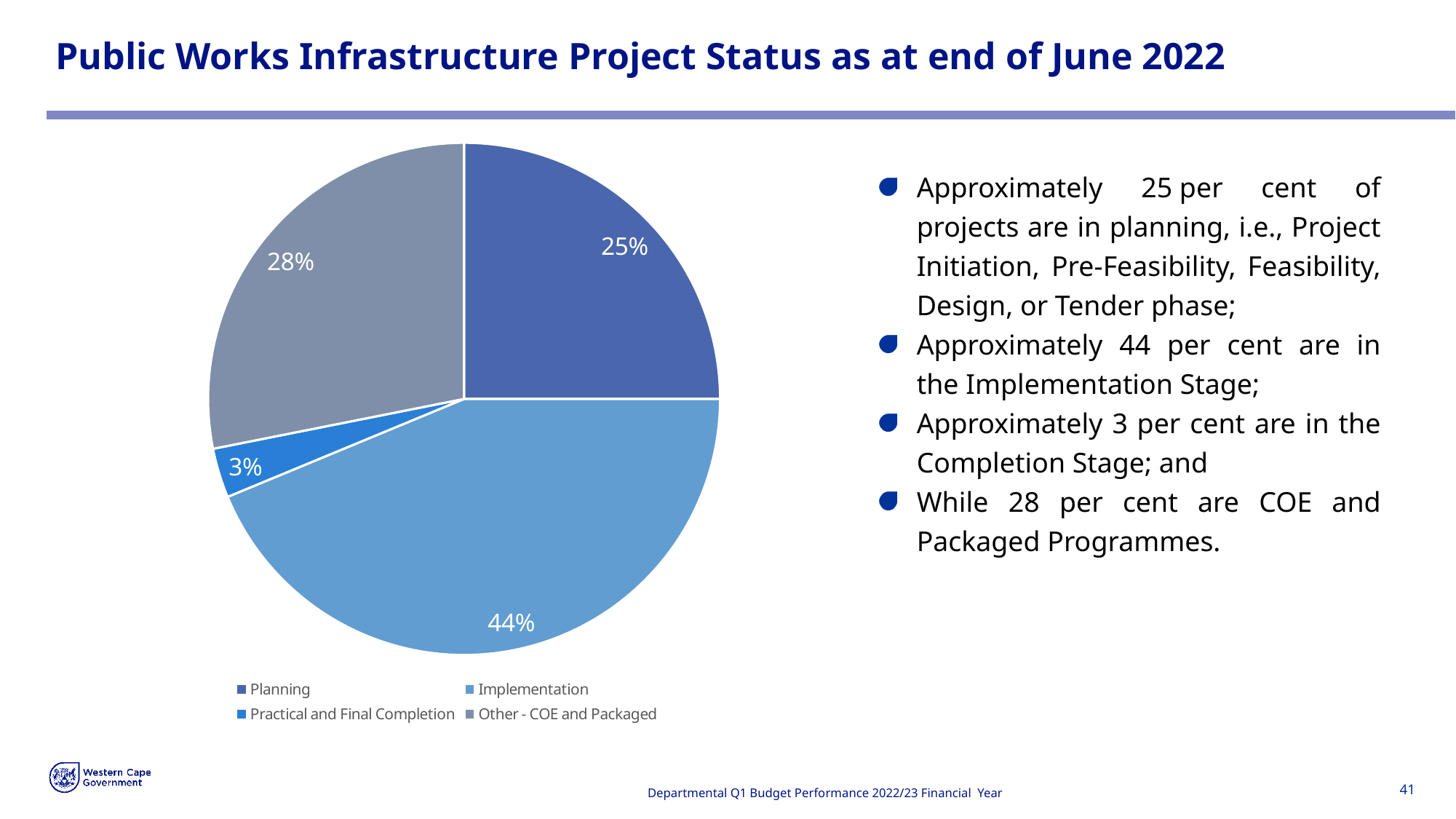
Which is larger, the share for Planning or the share for Other - COE and Packaged? Other - COE and Packaged What kind of chart is shown on the slide? Pie chart How many categories does the pie chart show? 4 What share of projects falls under Other - COE and Packaged? 28% Which category has the largest share of the pie? Implementation Which category has the smallest share of the pie? Practical and Final Completion What is the difference in percentage points between Implementation and Planning? 19 What share of projects is in Practical and Final Completion? 3% What share of projects is in the Implementation stage? 44% What is the combined share of Planning and Implementation? 69% What share of projects is in Planning? 25% What is the title of the slide containing the chart? Public Works Infrastructure Project Status as at end of June 2022